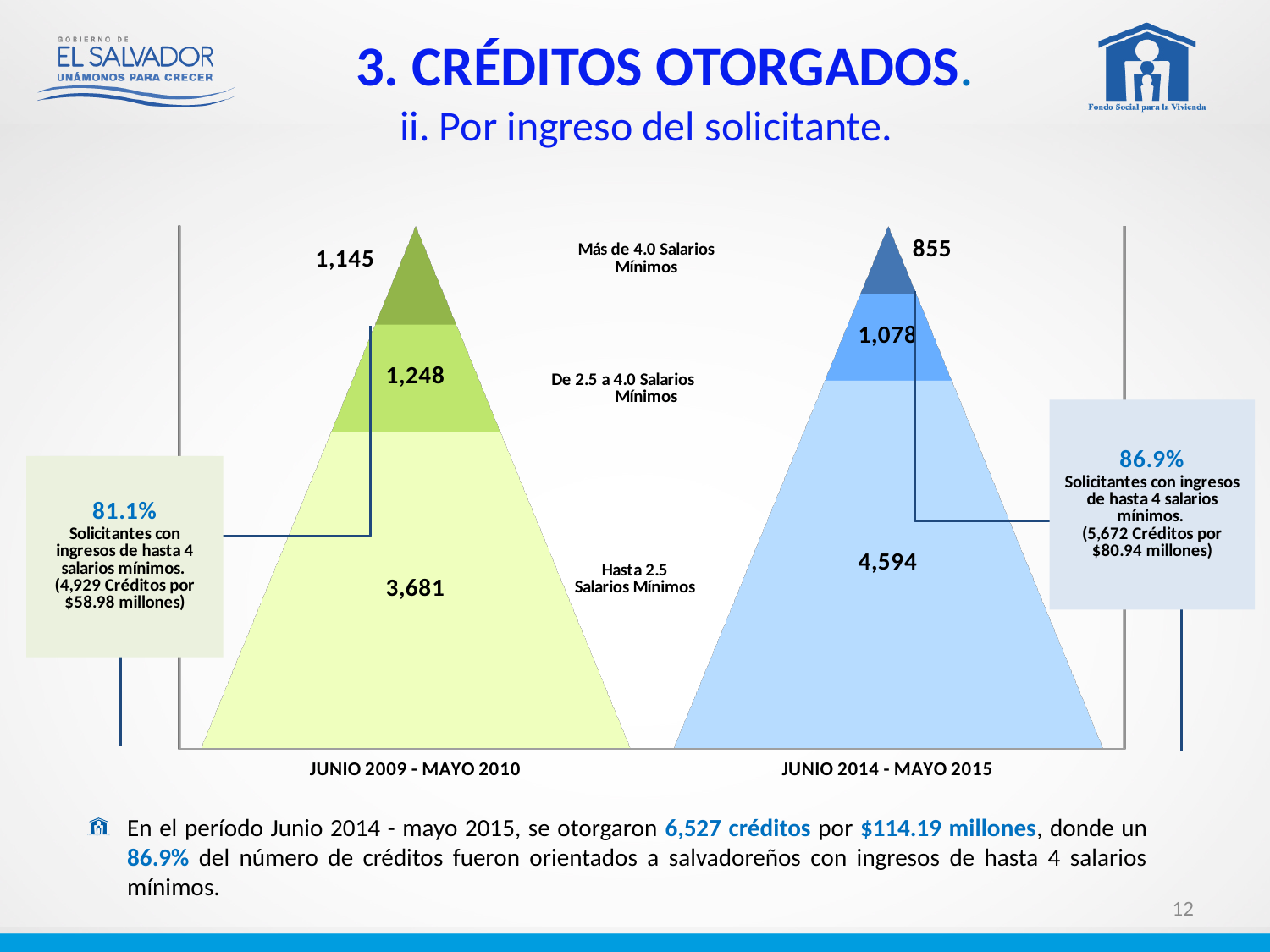
What is the total number of credits across the three income bands in the Junio 2009 - Mayo 2010 pyramid? 6,074 What is the difference between the Hasta 2.5 Salarios Mínimos values of the Junio 2014 - Mayo 2015 pyramid and the Junio 2009 - Mayo 2010 pyramid? 913 What is the total number of credits across the three income bands in the Junio 2014 - Mayo 2015 pyramid? 6,527 In the Junio 2009 - Mayo 2010 pyramid, which income band has the highest number of credits? Hasta 2.5 Salarios Mínimos What is the difference between the Más de 4.0 Salarios Mínimos values of the Junio 2009 - Mayo 2010 pyramid and the Junio 2014 - Mayo 2015 pyramid? 290 What percentage of applicants in the Junio 2014 - Mayo 2015 period had incomes of up to 4 minimum salaries, according to the callout box? 86.9% In the Junio 2014 - Mayo 2015 pyramid, how many credits were granted to applicants with income of Más de 4.0 Salarios Mínimos? 855 In the Junio 2009 - Mayo 2010 pyramid, how many credits were granted to applicants with income of Hasta 2.5 Salarios Mínimos? 3,681 In the Junio 2014 - Mayo 2015 pyramid, which income band has the lowest number of credits? Más de 4.0 Salarios Mínimos How many income bands are shown in each pyramid? 3 Which period has the larger value for De 2.5 a 4.0 Salarios Mínimos, Junio 2009 - Mayo 2010 or Junio 2014 - Mayo 2015? Junio 2009 - Mayo 2010 In the Junio 2014 - Mayo 2015 pyramid, what is the value for De 2.5 a 4.0 Salarios Mínimos? 1,078